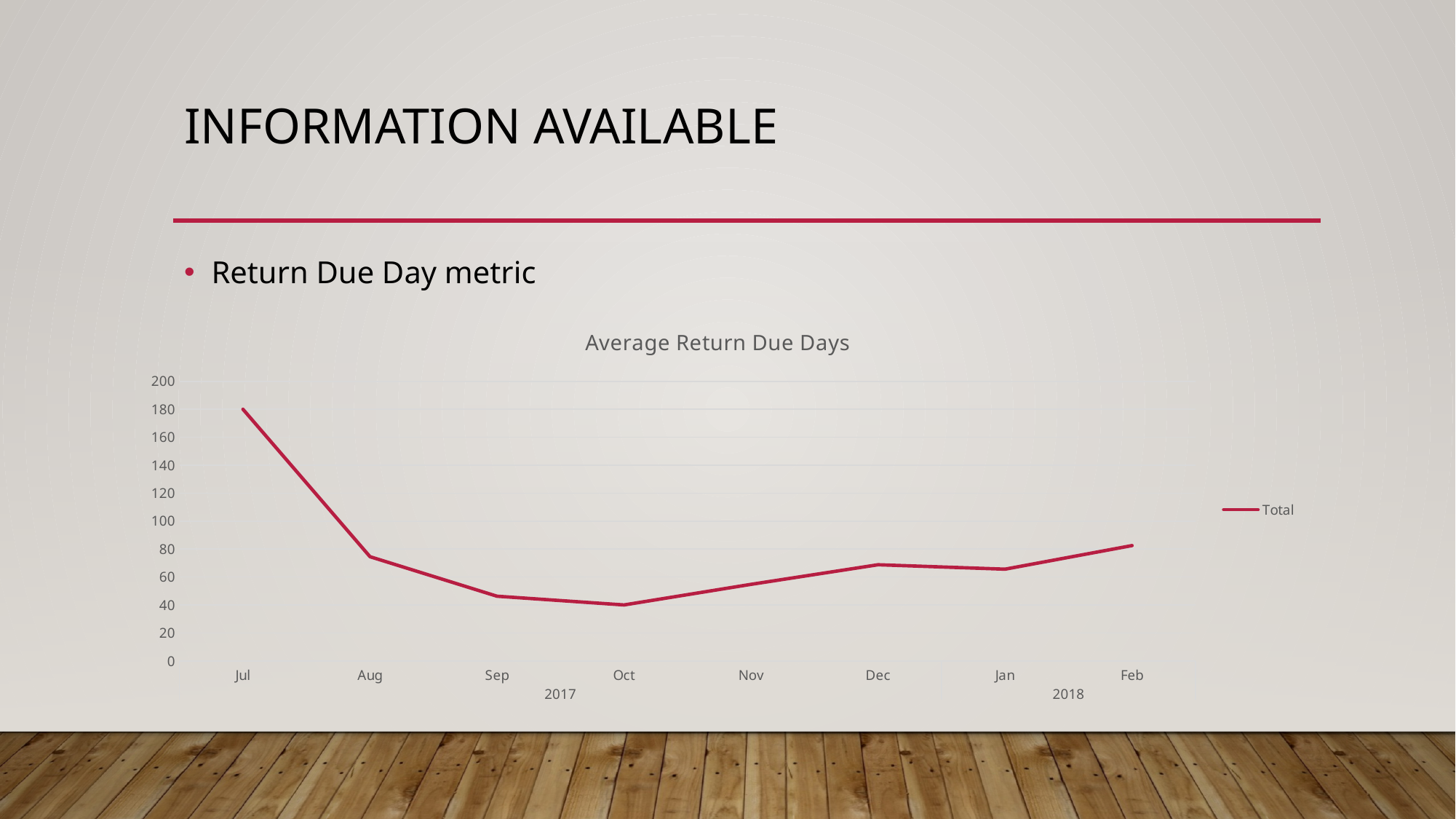
Which is larger, the value for Jul or the value for Feb? Jul Do the values rise or fall from Jul to Oct? fall Which month has the highest value for Total? Jul How many series does the legend list? 1 Is the value for Aug greater or less than 100? less Which month has the lowest value for Total? Oct What is the title of the chart? Average Return Due Days How many months are plotted along the x axis? 8 What is the name of the series shown in the legend? Total Is the value for Jul greater or less than 160? greater What kind of chart is shown on the slide? line chart Is the value for Oct greater or less than 60? less